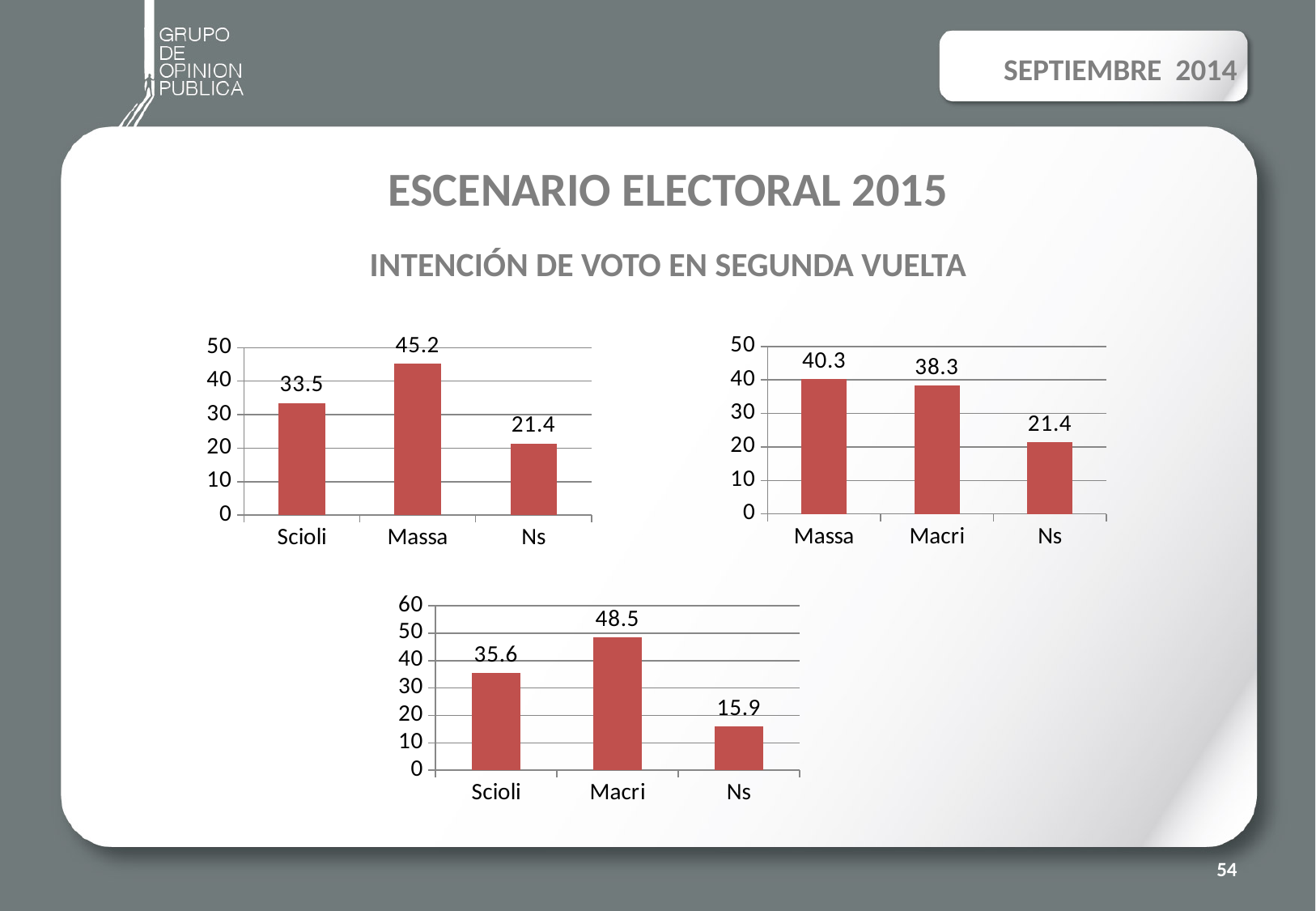
In the top-right chart (Massa, Macri, Ns), which category has the lowest value? Ns In the top-left chart (Scioli, Massa, Ns), what is the difference between Massa and Scioli? 11.7 In the top-right chart (Massa, Macri, Ns), what is the value for Macri? 38.3 How many categories are shown in the bottom chart (Scioli, Macri, Ns)? 3 In the bottom chart (Scioli, Macri, Ns), what is the difference between Macri and Scioli? 12.9 In the top-right chart (Massa, Macri, Ns), which is larger, Massa or Macri? Massa In the top-left chart (Scioli, Massa, Ns), what is the value for Massa? 45.2 In the bottom chart (Scioli, Macri, Ns), which category has the highest value? Macri What kind of chart is the top-left chart (Scioli, Massa, Ns)? Bar chart How many charts are shown on the slide? 3 In the top-left chart (Scioli, Massa, Ns), which category has the highest value? Massa In the bottom chart (Scioli, Macri, Ns), what is the value for Ns? 15.9